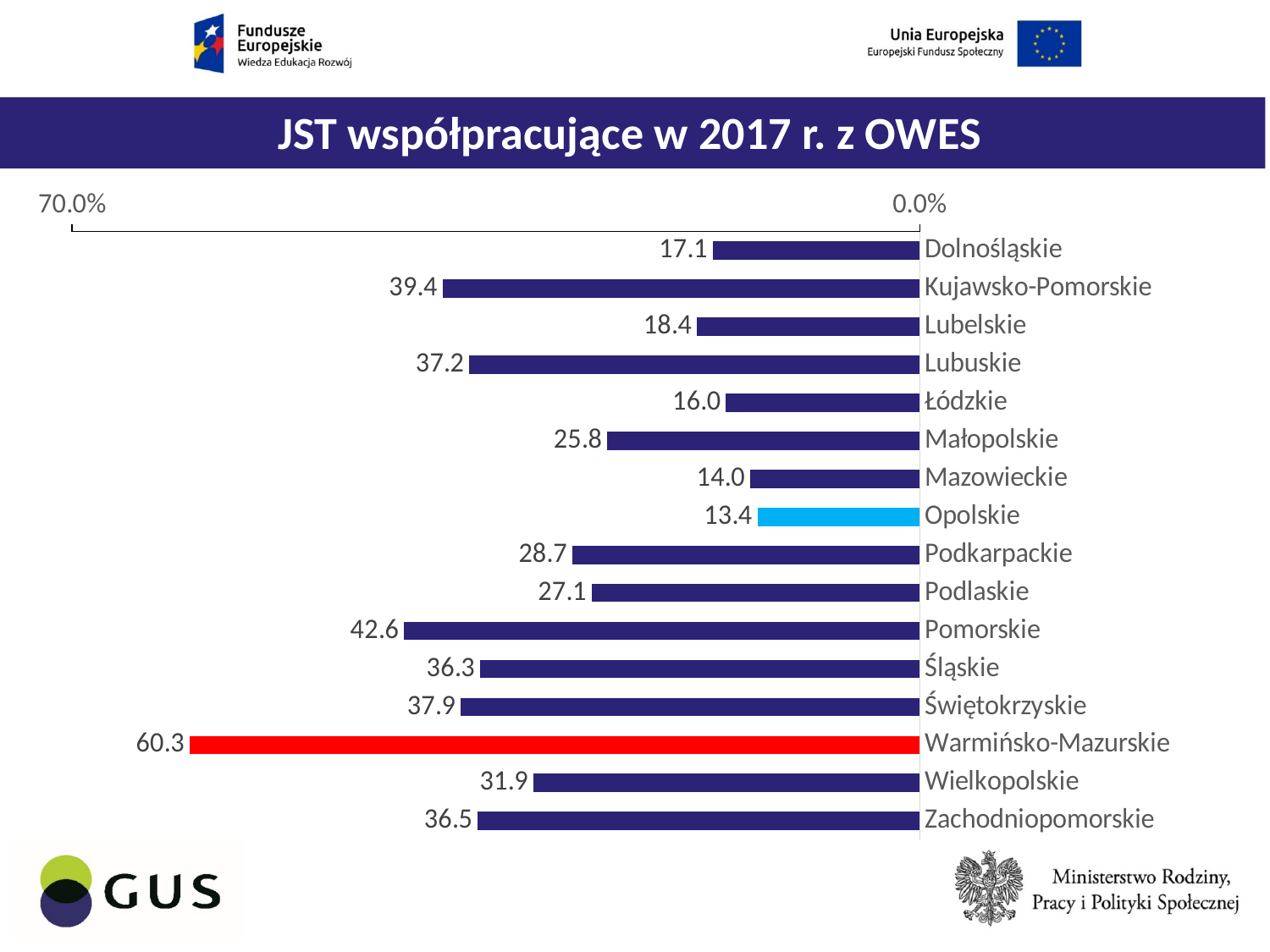
Which voivodeship has the lowest value? Opolskie What kind of chart is shown on the slide? Bar chart What is the value for Warmińsko-Mazurskie? 60.3 Which has a larger value, Lubuskie or Świętokrzyskie? Świętokrzyskie Which has a larger value, Mazowieckie or Łódzkie? Łódzkie What is the difference between the values for Pomorskie and Śląskie? 6.3 What is the value for Opolskie? 13.4 What is the title of the chart? JST współpracujące w 2017 r. z OWES What is the value for Kujawsko-Pomorskie? 39.4 Which voivodeship has the highest value? Warmińsko-Mazurskie What is the difference between the values for Warmińsko-Mazurskie and Opolskie? 46.9 How many voivodeships are shown in the chart? 16